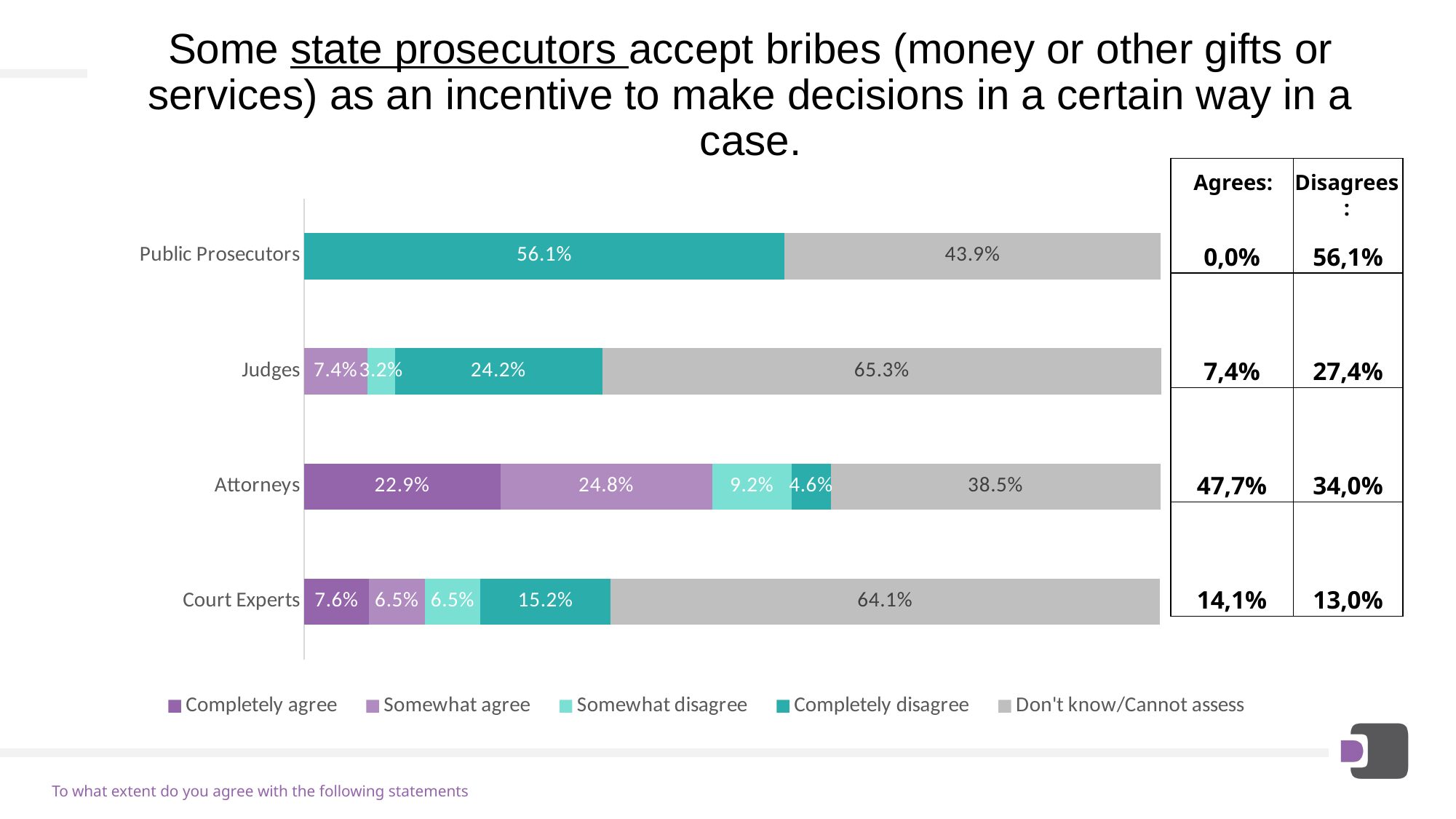
Which is larger: the "Completely disagree" share for Judges or for Court Experts? Judges Which group has the highest "Completely agree" share? Attorneys Which group has the lowest "Don't know/Cannot assess" share? Attorneys How many series does the legend list? 5 How many groups (categories) are shown on the chart? 4 What is the difference between the "Don't know/Cannot assess" shares for Judges and Court Experts? 1.2% What percentage of Attorneys answered "Somewhat agree"? 24.8% What percentage of Court Experts answered "Completely disagree"? 15.2% What percentage of Judges answered "Don't know/Cannot assess"? 65.3% What colour represents "Don't know/Cannot assess" in the chart? Grey What percentage of Public Prosecutors answered "Completely disagree"? 56.1% What kind of chart is shown on the slide? Stacked bar chart